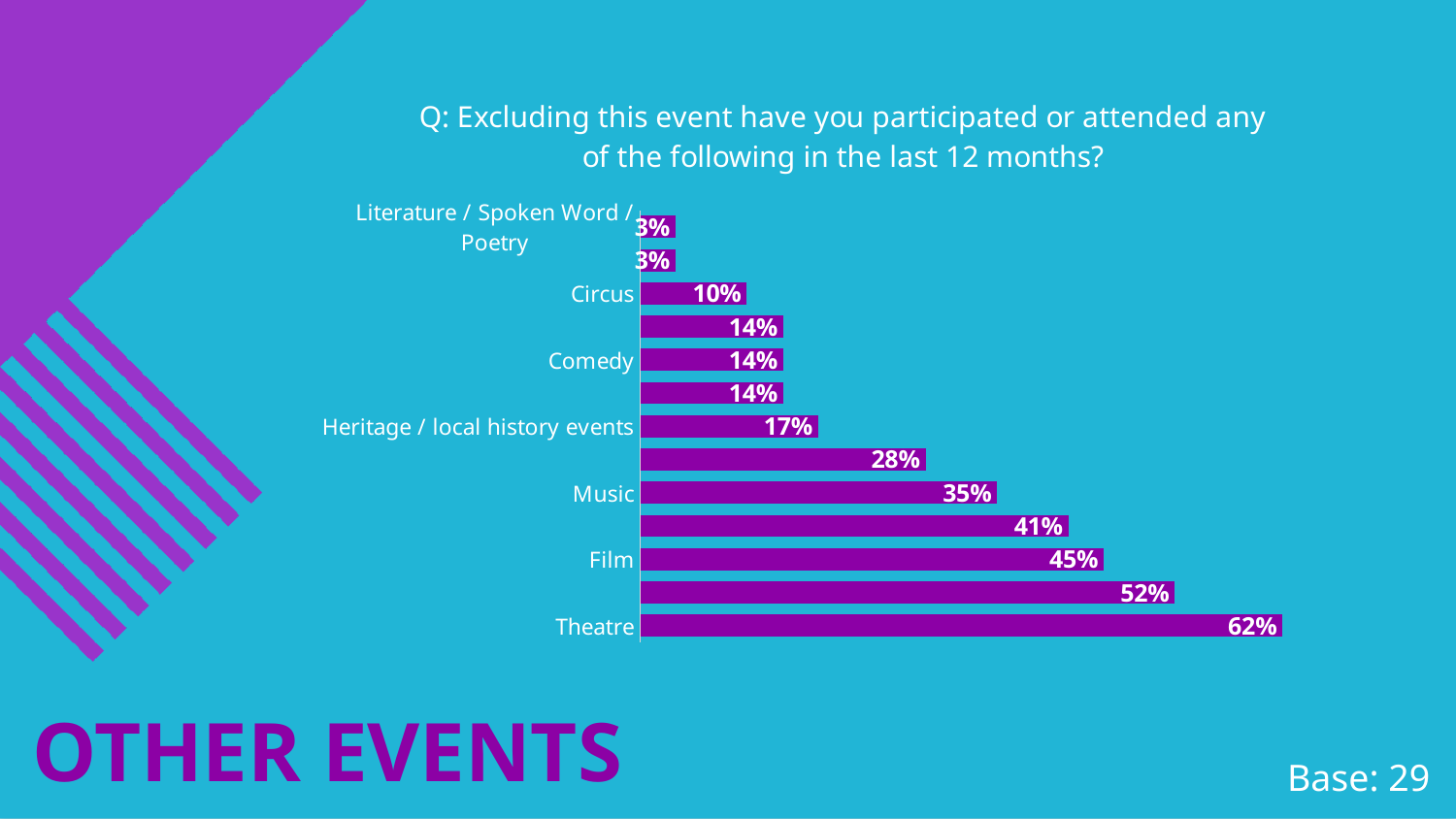
What is the value shown for Circus? 10% Which labelled category has the highest value? Theatre What is the value shown for Literature / Spoken Word / Poetry? 3% How many bars are plotted on the chart? 13 What kind of chart is shown on the slide? Bar chart What is the value shown for Film? 45% What is the difference in percentage points between Theatre and Film? 17 What percentage of respondents attended Theatre in the last 12 months? 62% What is the lowest value shown on the chart? 3% Which has a higher value, Music or Comedy? Music What is the value shown for Heritage / local history events? 17% What is the value shown for Music? 35%